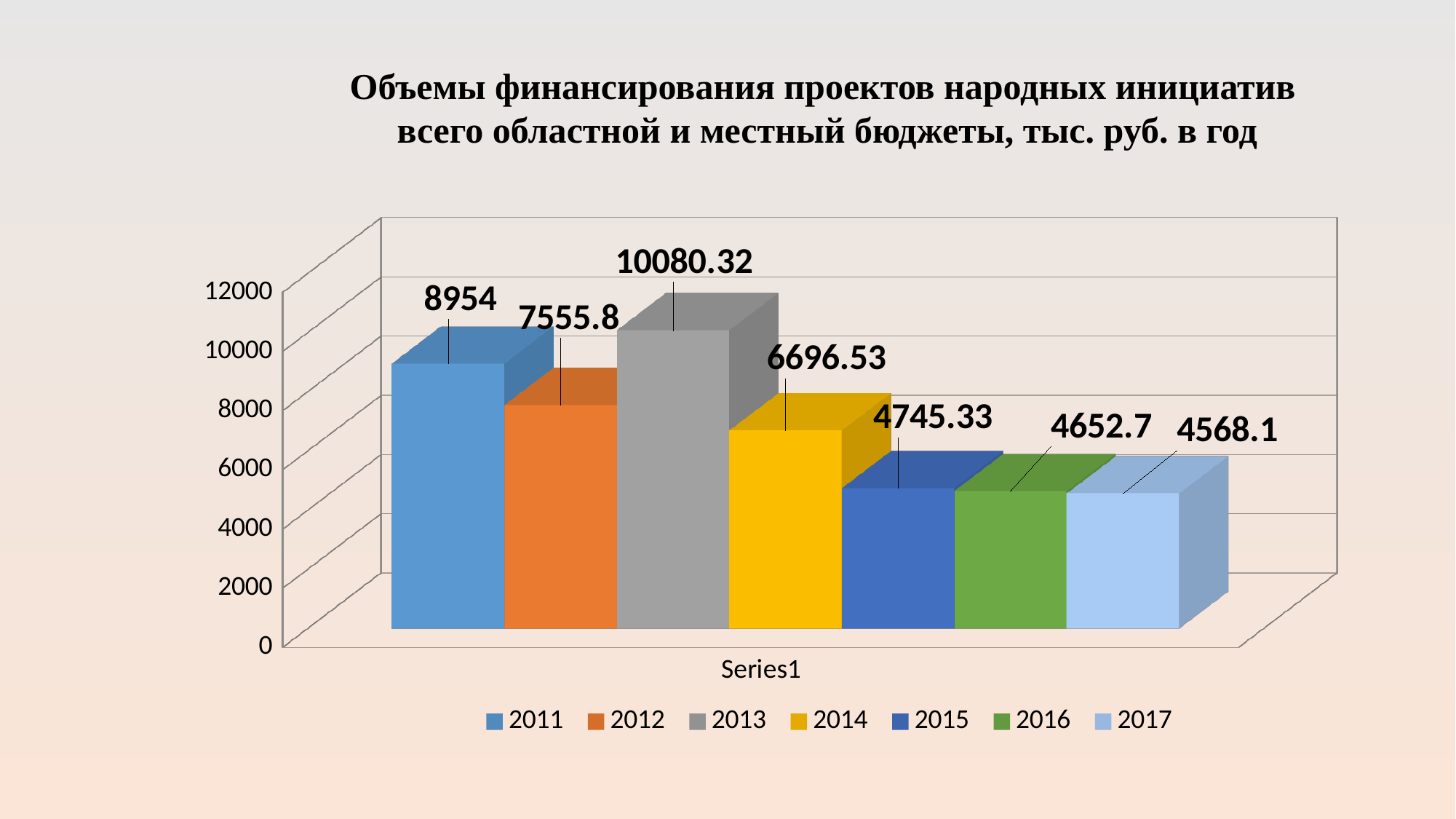
Which is larger, the value for 2016 or the value for 2017? 2016 What is the value for 2013? 10080.32 What is the difference between the values for 2011 and 2012? 1398.2 What is the value for 2014? 6696.53 What is the value for 2011? 8954 Which year has the highest value? 2013 What kind of chart is shown on the slide? bar chart How many entries does the legend list? 7 How many bars are plotted on the chart? 7 Which year has the lowest value? 2017 What is the value for 2017? 4568.1 What is the difference between the values for 2013 and 2011? 1126.32